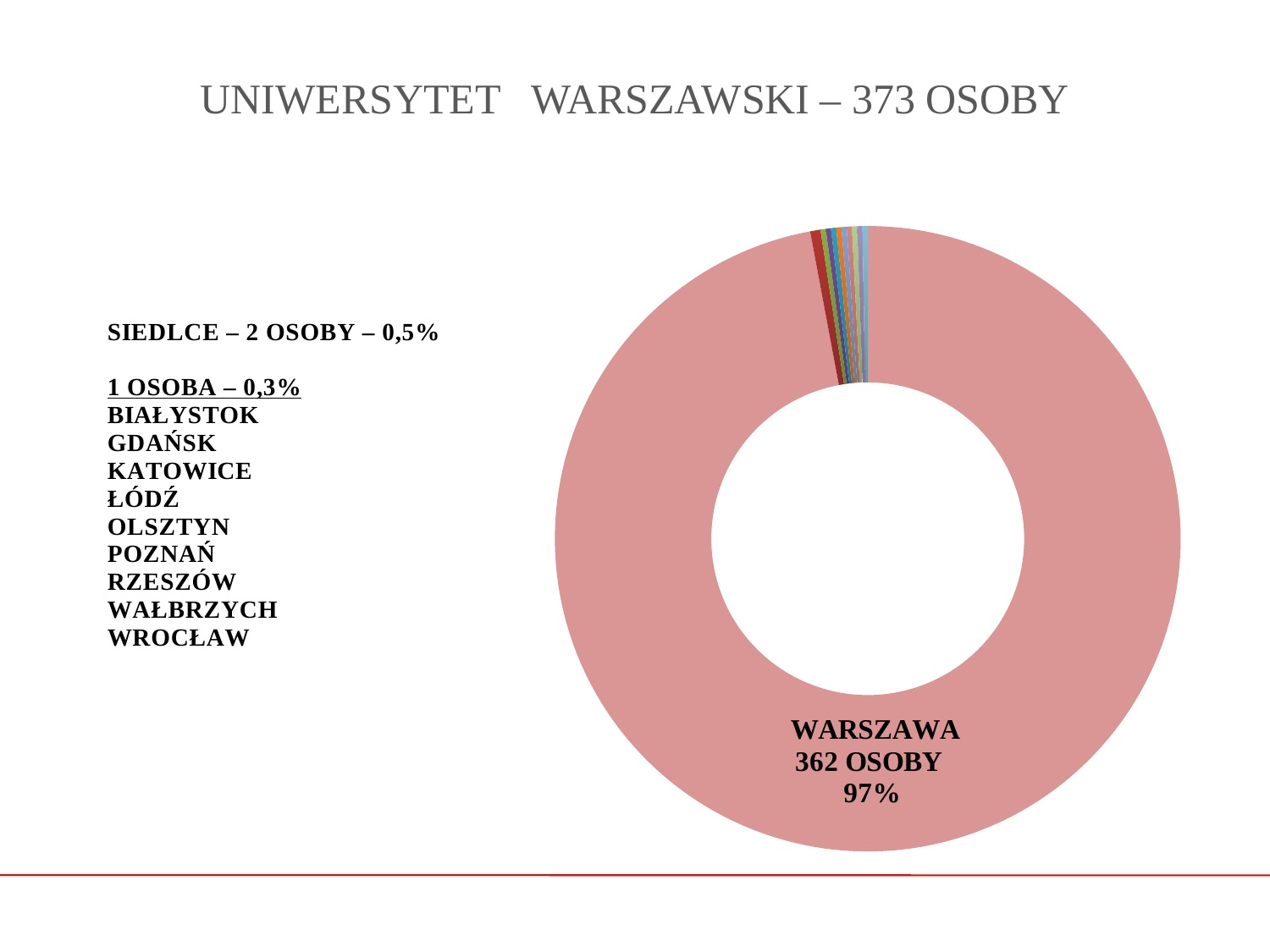
What percentage share does Białystok have? 0,3% What is the title of the slide? UNIWERSYTET WARSZAWSKI – 373 OSOBY What is the difference in number of people between Warszawa and Siedlce? 360 How many people are in the Gdańsk category? 1 How many categories (cities) are represented in the chart? 11 Which is larger, the value for Warszawa or the value for Siedlce? Warszawa How many people are in the Siedlce category? 2 What kind of chart is shown on the slide? Pie chart (donut) Which category has the largest slice of the pie? Warszawa What share of the pie does Warszawa represent? 97% What percentage share does Siedlce have? 0,5% How many people (osoby) are in the Warszawa slice? 362